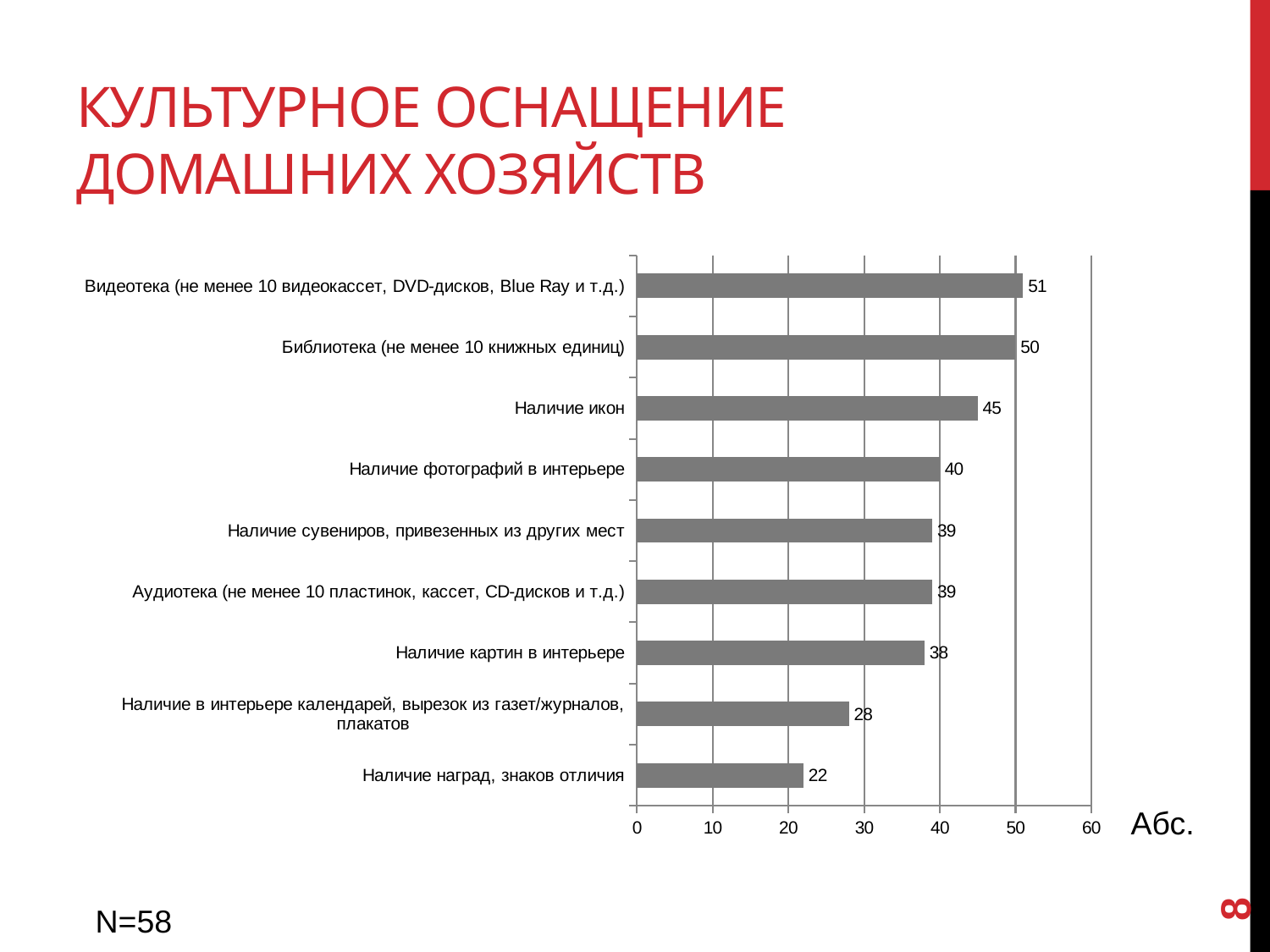
How many categories are shown in the chart? 9 What is the value for Наличие в интерьере календарей, вырезок из газет/журналов, плакатов? 28 What is the value for Видеотека (не менее 10 видеокассет, DVD-дисков, Blue Ray и т.д.)? 51 What is the sample size (N) stated on the slide? N=58 What kind of chart is shown on the slide? bar chart Which category has the lowest value? Наличие наград, знаков отличия What is the value for Наличие икон? 45 What is the difference between the values for Библиотека (не менее 10 книжных единиц) and Наличие картин в интерьере? 12 Is the value for Наличие икон greater or less than 40? greater Which category has the highest value? Видеотека (не менее 10 видеокассет, DVD-дисков, Blue Ray и т.д.) What is the value for Наличие наград, знаков отличия? 22 Which is larger: the value for Наличие фотографий в интерьере or the value for Наличие сувениров, привезенных из других мест? Наличие фотографий в интерьере